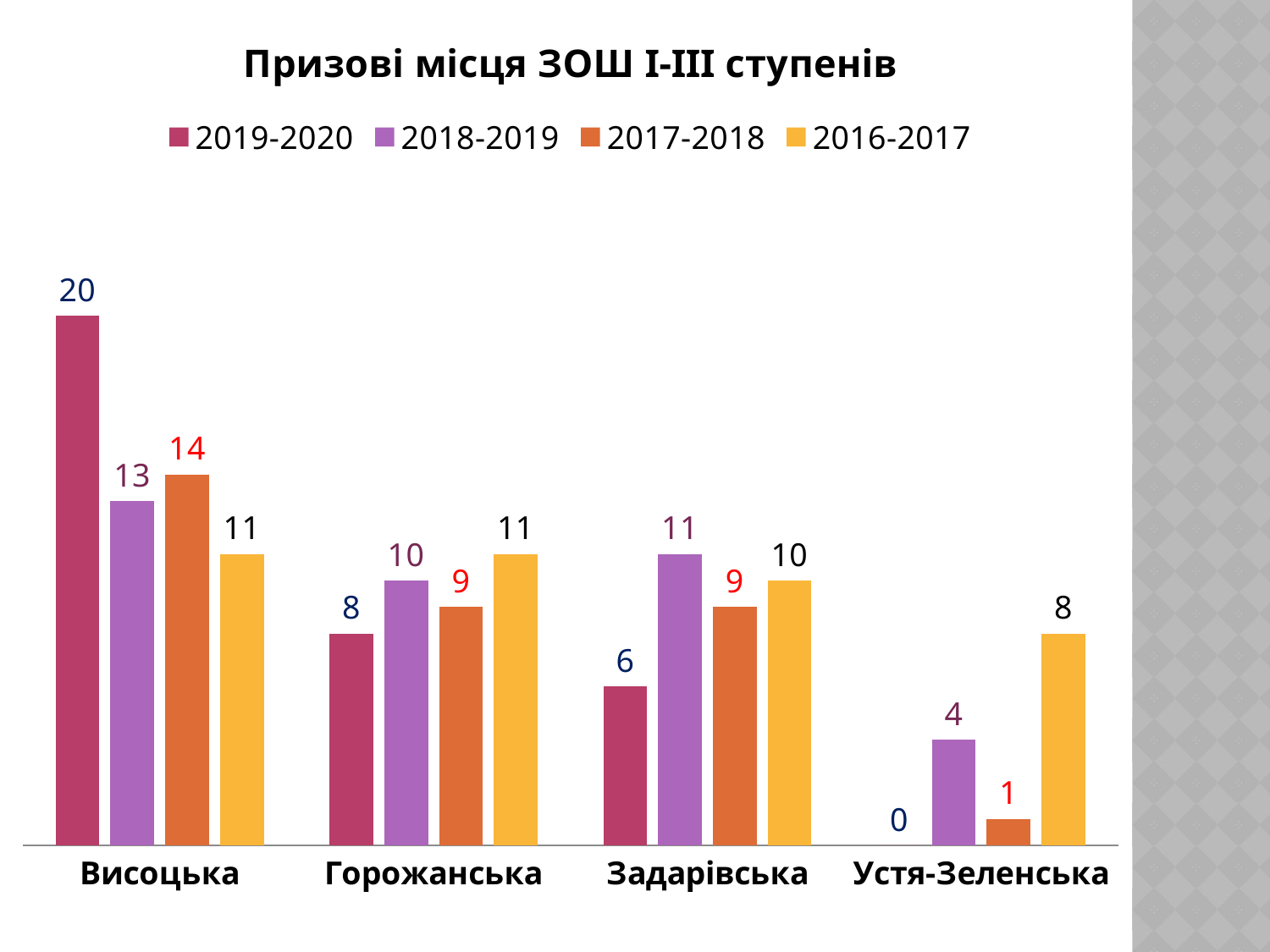
Which is larger for Горожанська: the 2018-2019 value or the 2017-2018 value? 2018-2019 What is the value for Устя-Зеленська in the 2017-2018 series? 1 What is the total of the four series values for Устя-Зеленська? 13 What is the title of the chart? Призові місця ЗОШ І-ІІІ ступенів What kind of chart is shown on the slide? Bar chart What is the difference between the 2019-2020 and 2016-2017 values for Висоцька? 9 How many series does the legend list? 4 Which category has the lowest value in the 2018-2019 series? Устя-Зеленська What is the value for Задарівська in the 2016-2017 series? 10 How many categories are shown on the x axis? 4 Which category has the highest value in the 2019-2020 series? Висоцька What is the value for Висоцька in the 2019-2020 series? 20